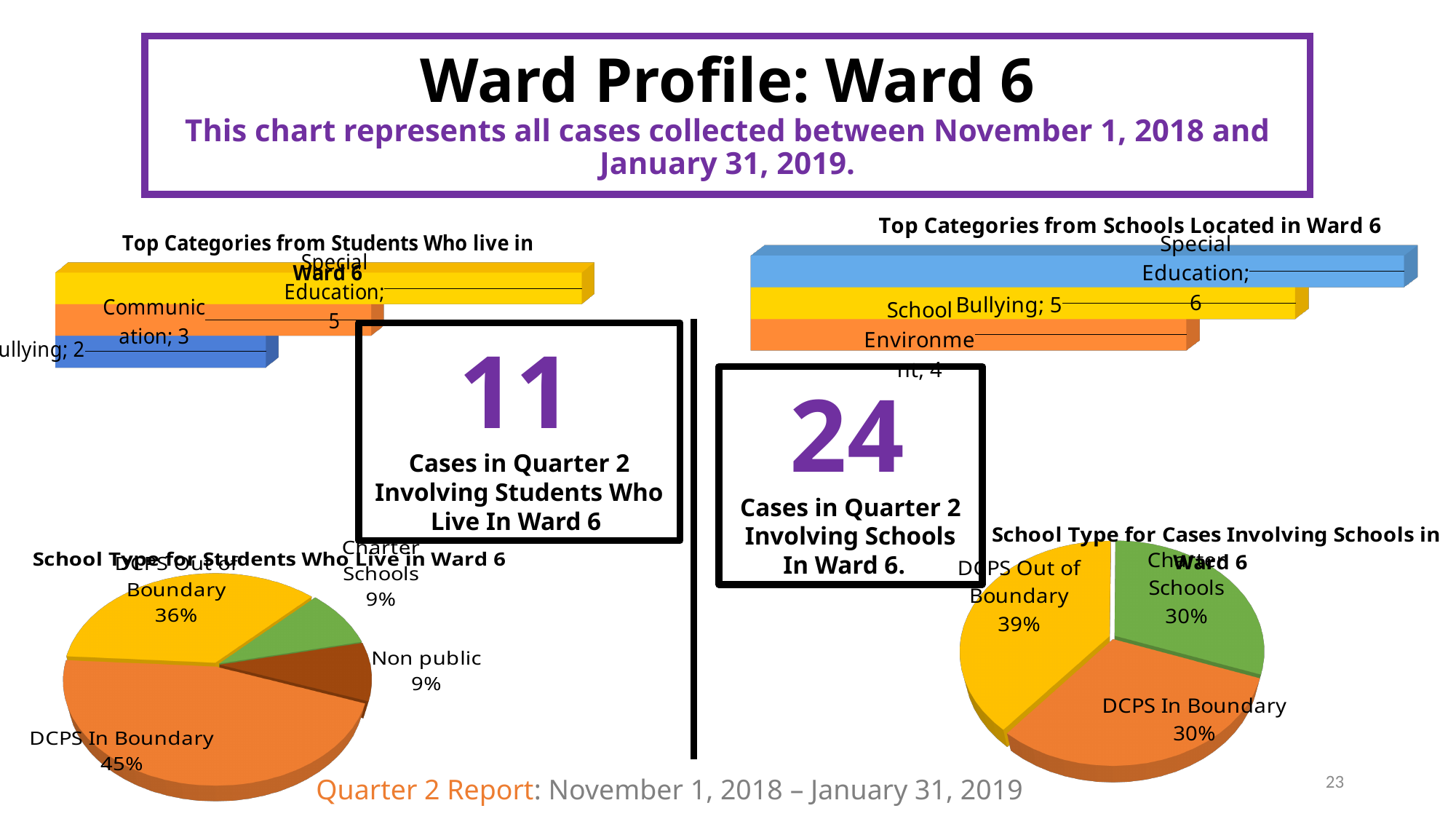
In the 'Top Categories from Schools Located in Ward 6' chart, how many categories are shown? 3 In the 'Top Categories from Students Who live in Ward 6' chart, what is the value for Special Education? 5 In the 'Top Categories from Students Who live in Ward 6' chart, what is the difference between Special Education and Communication? 2 In the 'School Type for Students Who Live in Ward 6' pie chart, how many slices are there? 4 In the 'Top Categories from Students Who live in Ward 6' chart, which category has the lowest value? Bullying In the 'Top Categories from Schools Located in Ward 6' chart, which category has the highest value? Special Education In the 'School Type for Students Who Live in Ward 6' pie chart, which slice is the largest? DCPS In Boundary In the 'Top Categories from Schools Located in Ward 6' chart, what is the value for Bullying? 5 In the 'School Type for Cases Involving Schools in Ward 6' pie chart, what share is DCPS Out of Boundary? 39% In the 'School Type for Students Who Live in Ward 6' pie chart, what share is DCPS In Boundary? 45% What type of chart is 'Top Categories from Schools Located in Ward 6'? Bar chart In the 'School Type for Cases Involving Schools in Ward 6' pie chart, which is larger: DCPS Out of Boundary or Charter Schools? DCPS Out of Boundary